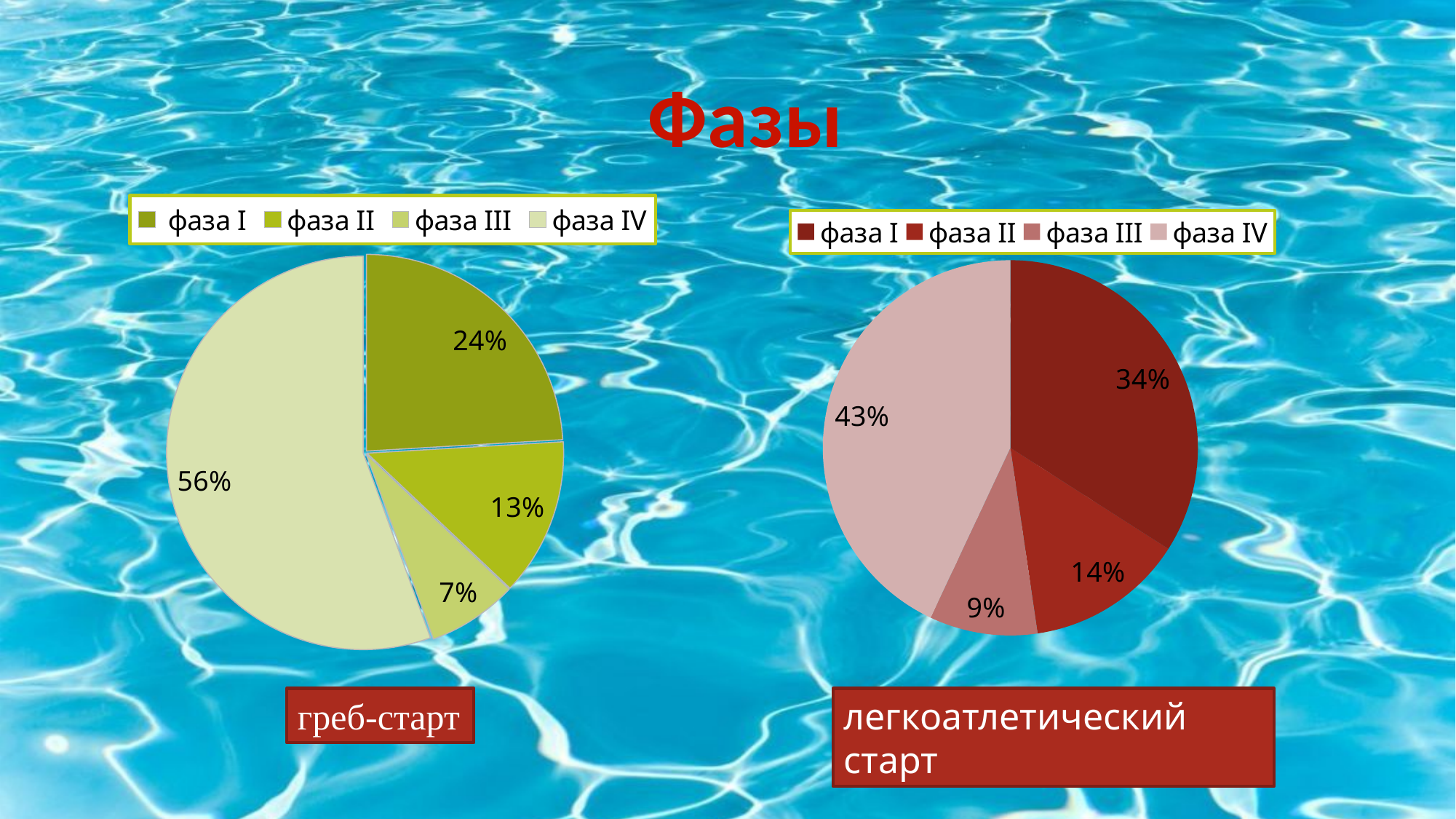
What type of chart is used for греб-старт? pie chart In the легкоатлетический старт chart, what is the difference between фаза IV and фаза I? 9% In the легкоатлетический старт chart, what share does фаза II have? 14% In the легкоатлетический старт chart, what share does фаза III have? 9% In the легкоатлетический старт chart, which phase has the smallest slice? фаза III In the греб-старт chart, which phase has the smallest slice? фаза III Which chart has the larger share for фаза I, греб-старт or легкоатлетический старт? легкоатлетический старт In the греб-старт chart, what share does фаза IV have? 56% How many slices does the легкоатлетический старт pie chart have? 4 In the греб-старт chart, what is the difference between фаза I and фаза II? 11% In the греб-старт chart, which phase has the largest slice? фаза IV In the греб-старт chart, what share does фаза I have? 24%